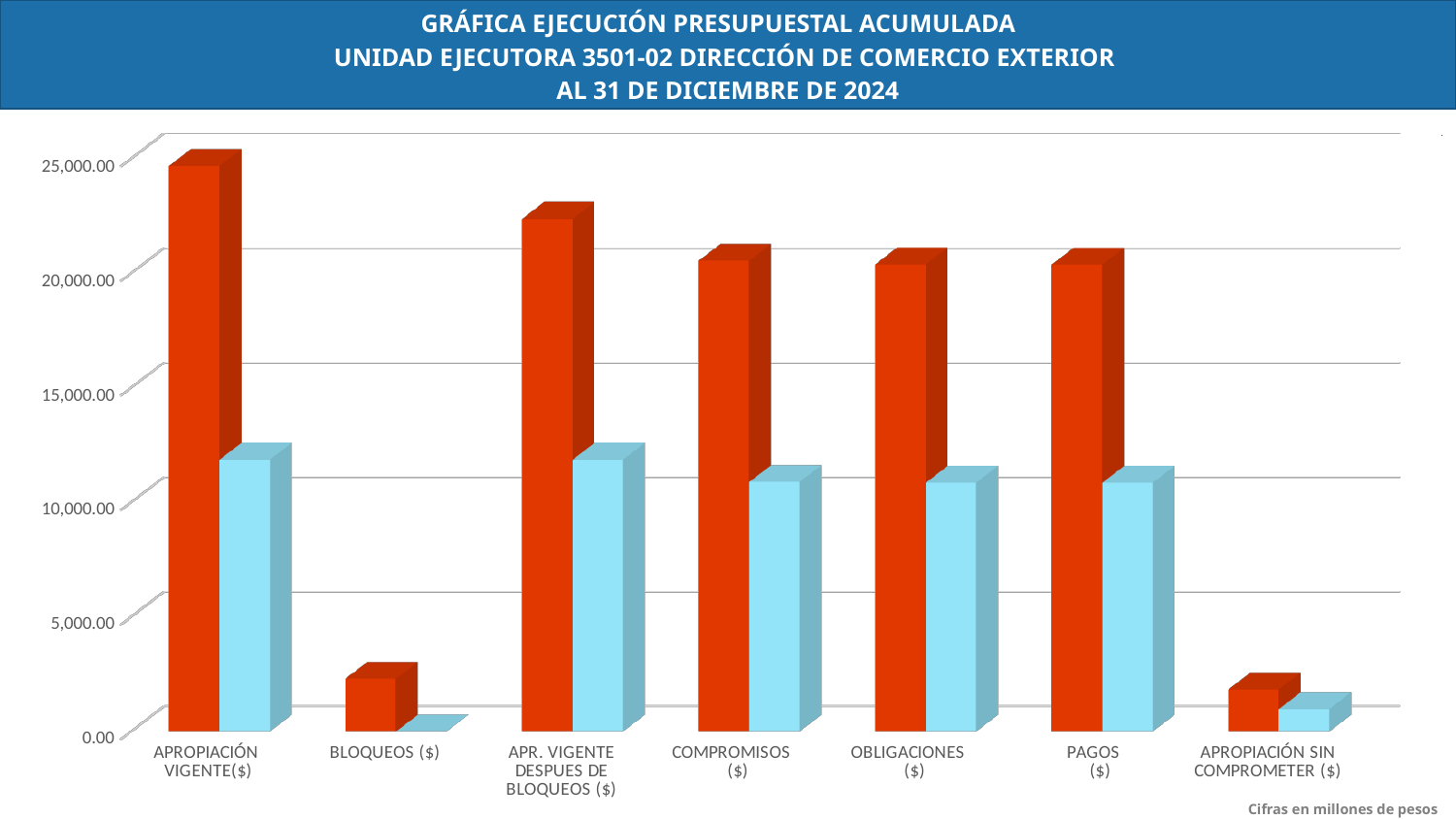
What kind of chart is shown on the slide? bar chart Is the red bar for APROPIACIÓN VIGENTE($) greater or less than 20,000.00? greater Is the red bar for COMPROMISOS ($) greater or less than 15,000.00? greater Is the red bar for APR. VIGENTE DESPUES DE BLOQUEOS ($) greater or less than 25,000.00? less Which category has the shortest light blue bar? BLOQUEOS ($) Which category has the tallest red bar? APROPIACIÓN VIGENTE($) According to the note at the bottom right of the slide, in what units are the figures expressed? millones de pesos Which red bar is taller: APROPIACIÓN VIGENTE($) or APR. VIGENTE DESPUES DE BLOQUEOS ($)? APROPIACIÓN VIGENTE($) How many categories are shown along the x axis of the chart? 7 For PAGOS ($), which bar is taller: the red bar or the light blue bar? the red bar